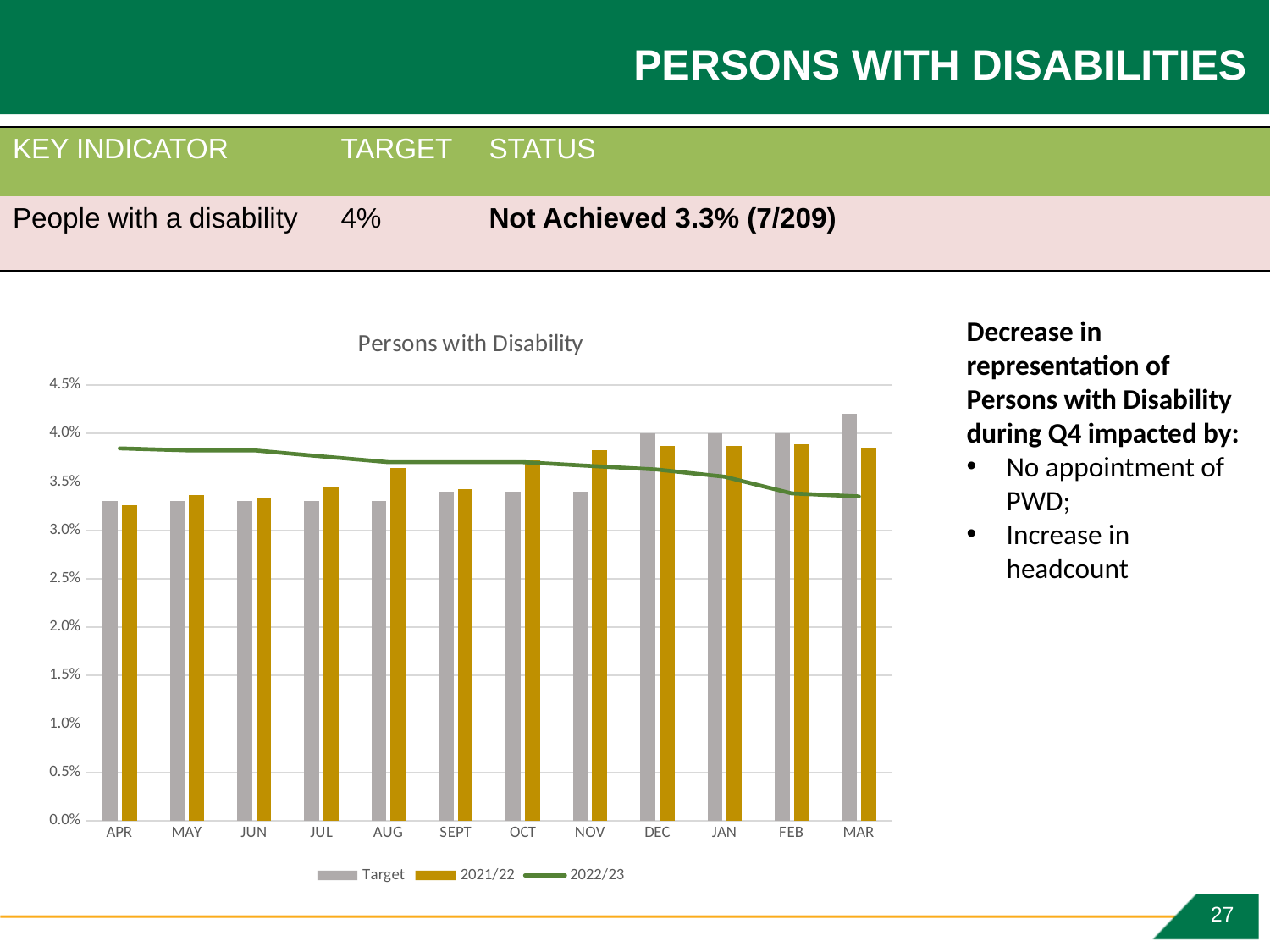
What kind of chart is shown on the slide? Bar chart with a line In which month is the Target bar highest? MAR How many series does the chart legend list? 3 Does the 2022/23 line rise or fall from APR to MAR? Fall Is the 2021/22 value for APR greater or less than 3.5%? less How many months are shown on the x axis of the chart? 12 Is the Target value for MAR greater or less than 4.0%? greater What is the Target value for DEC? 4.0% In NOV, which is larger: the Target bar or the 2021/22 bar? 2021/22 In MAR, which is larger: the Target bar or the 2021/22 bar? Target What is the title of the chart? Persons with Disability Which series is drawn as a line rather than bars? 2022/23